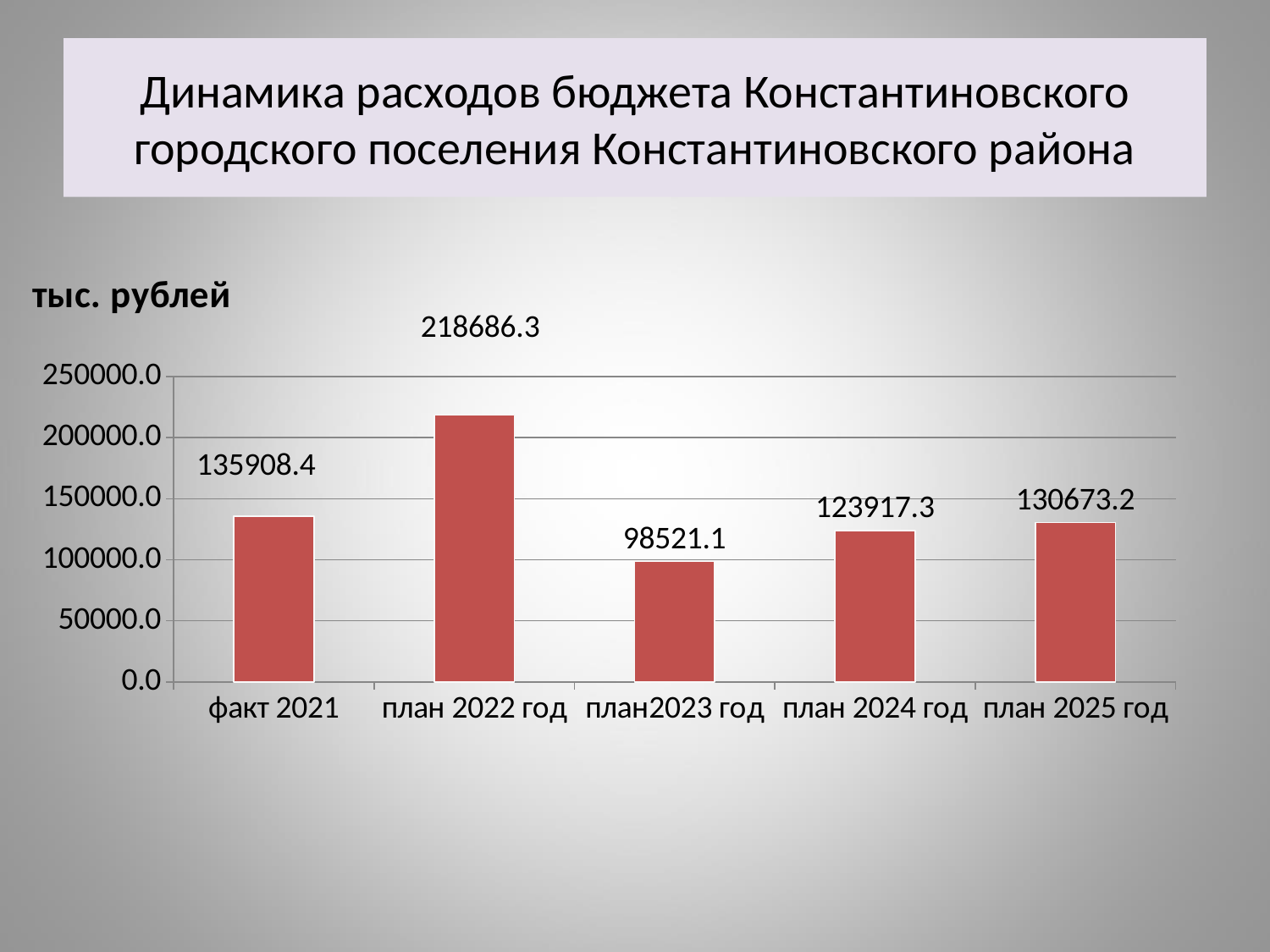
Which is larger, the value for факт 2021 or the value for план 2024 год? факт 2021 Which category has the lowest value? план2023 год Which category has the highest value? план 2022 год What is the value for план2023 год? 98521.1 How many categories are shown on the x axis? 5 What is the difference between the values for план 2022 год and факт 2021? 82777.9 What is the value for факт 2021? 135908.4 What is the value for план 2025 год? 130673.2 Is the value for план2023 год greater or less than 100000.0? less What kind of chart is shown on the slide? bar chart What is the difference between the values for план 2025 год and план 2024 год? 6755.9 What is the value for план 2022 год? 218686.3